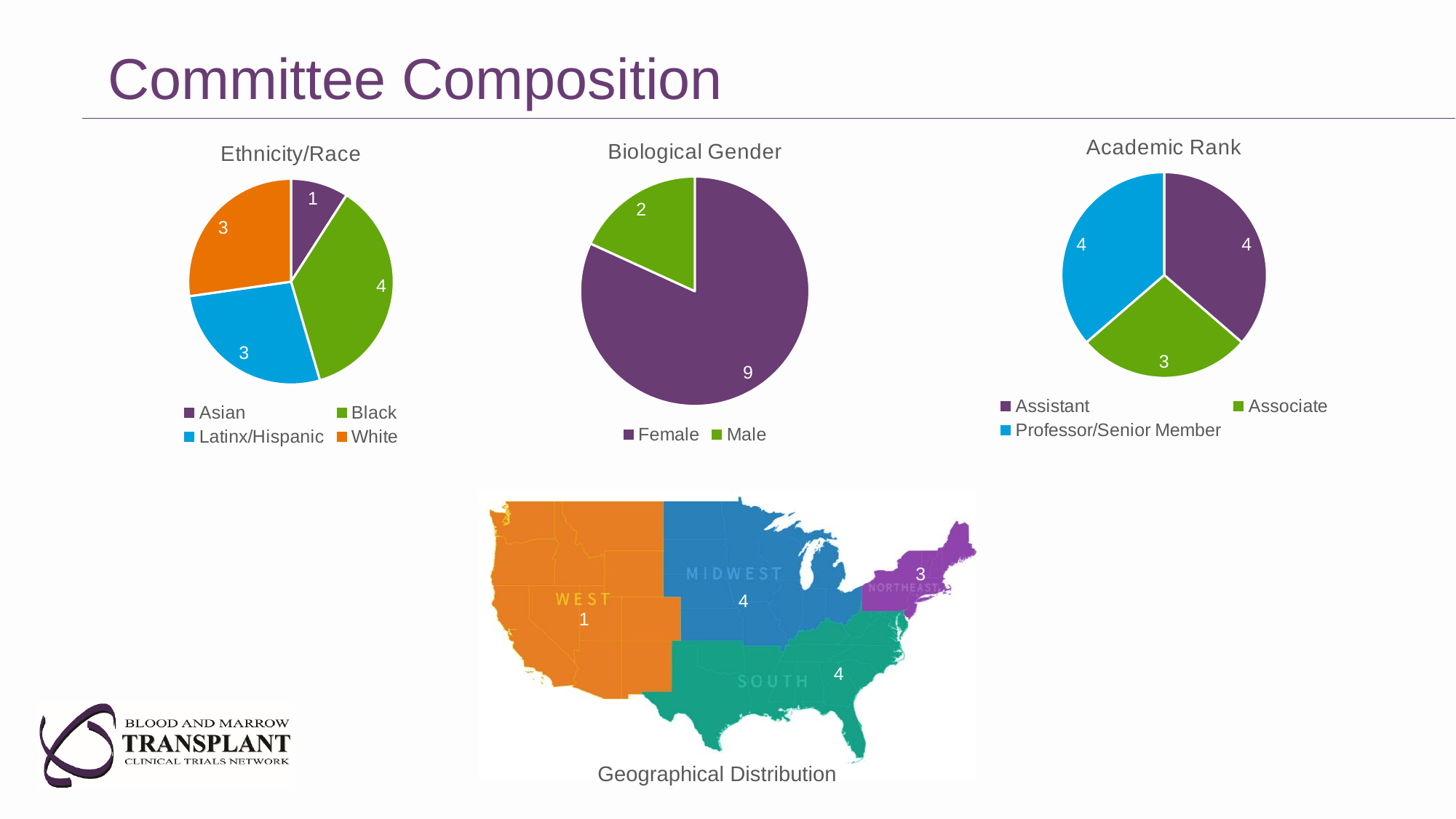
In the Ethnicity/Race chart, which category has the smallest slice? Asian In the Ethnicity/Race chart, which category has the largest slice? Black In the Geographical Distribution map, what is the value for the Midwest region? 4 In the Biological Gender chart, which is larger, Female or Male? Female What kind of chart is the Biological Gender chart? Pie chart In the Academic Rank chart, what is the value for Associate? 3 In the Academic Rank chart, which colour represents Professor/Senior Member? Blue In the Ethnicity/Race chart, what is the value for Black? 4 In the Ethnicity/Race chart, how many categories does the legend list? 4 In the Biological Gender chart, what is the difference between the Female and Male values? 7 In the Academic Rank chart, what is the total of all slices? 11 In the Biological Gender chart, what is the value for Female? 9